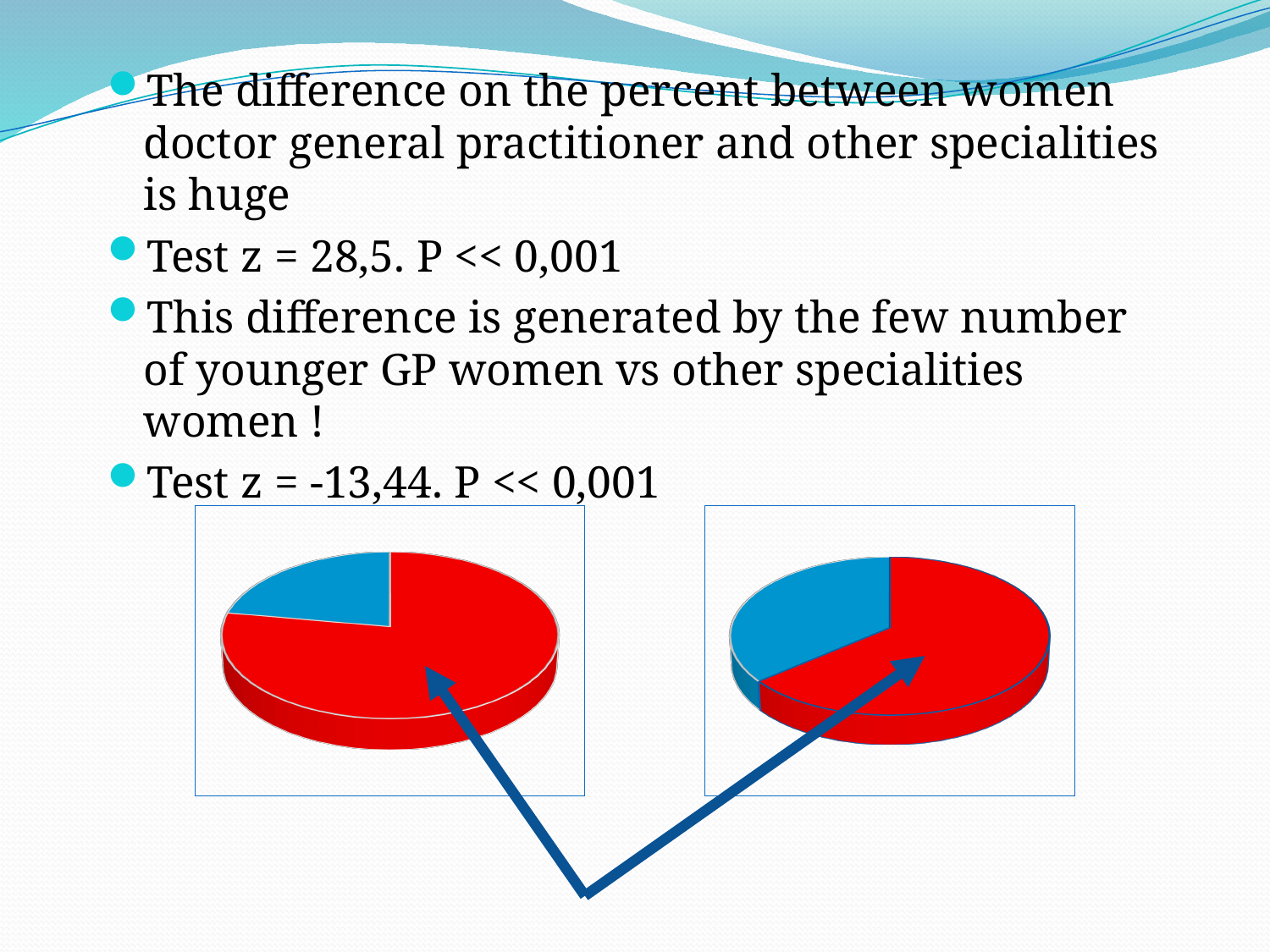
In the pie chart on the left of the slide, which slice is the smallest? the blue slice What two colours are used for the slices in the pie charts on the slide? red and blue In the pie chart on the right of the slide, which slice is the largest? the red slice Is the blue slice in the pie chart on the left of the slide more or less than half of the pie? less In the pie chart on the left of the slide, which slice is larger, the red one or the blue one? the red one How many slices does the pie chart on the left of the slide have? 2 What kind of chart is the chart on the left of the slide? pie chart Which pie chart on the slide has the larger blue slice, the left one or the right one? the right one How many slices does the pie chart on the right of the slide have? 2 Is the red slice in the pie chart on the right of the slide more or less than half of the pie? more In the pie chart on the right of the slide, which slice is larger, the red one or the blue one? the red one What kind of chart is the chart on the right of the slide? pie chart